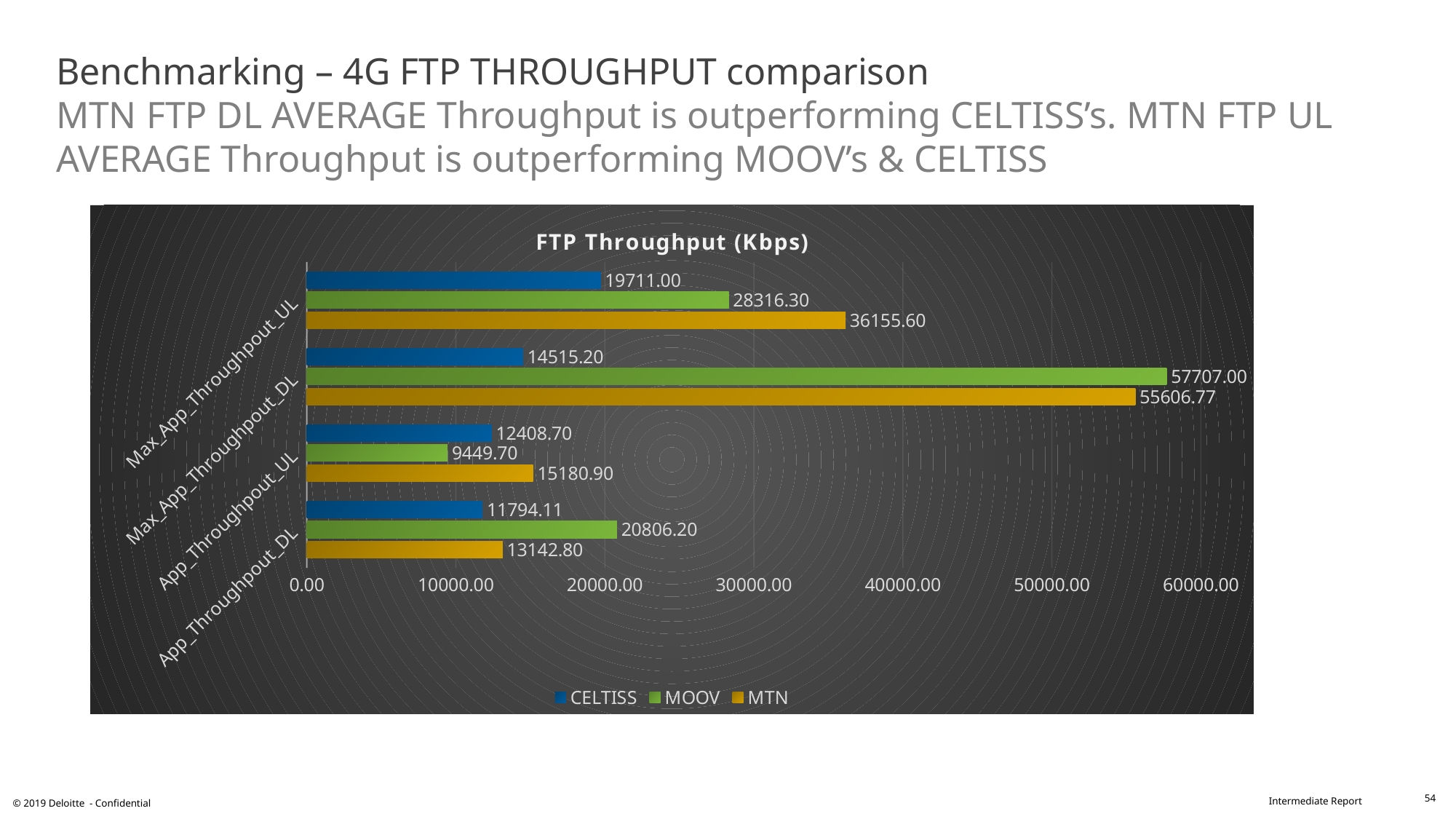
How many categories are shown on the vertical axis? 4 What is the MOOV value for App_Throughpout_UL? 9449.70 Which operator has the lowest value for App_Throughpout_UL? MOOV How many series does the legend list? 3 What is the CELTISS value for App_Throughpout_DL? 11794.11 What is the MTN value for Max_App_Throughpout_UL? 36155.60 What is the CELTISS value for Max_App_Throughpout_DL? 14515.20 What is the difference between the MOOV and CELTISS values for App_Throughpout_DL? 9012.09 Which operator has the highest value for Max_App_Throughpout_DL? MOOV For App_Throughpout_DL, which is larger: the MOOV value or the MTN value? MOOV What type of chart is shown on the slide? Bar chart What is the difference between the MTN and CELTISS values for Max_App_Throughpout_UL? 16444.60